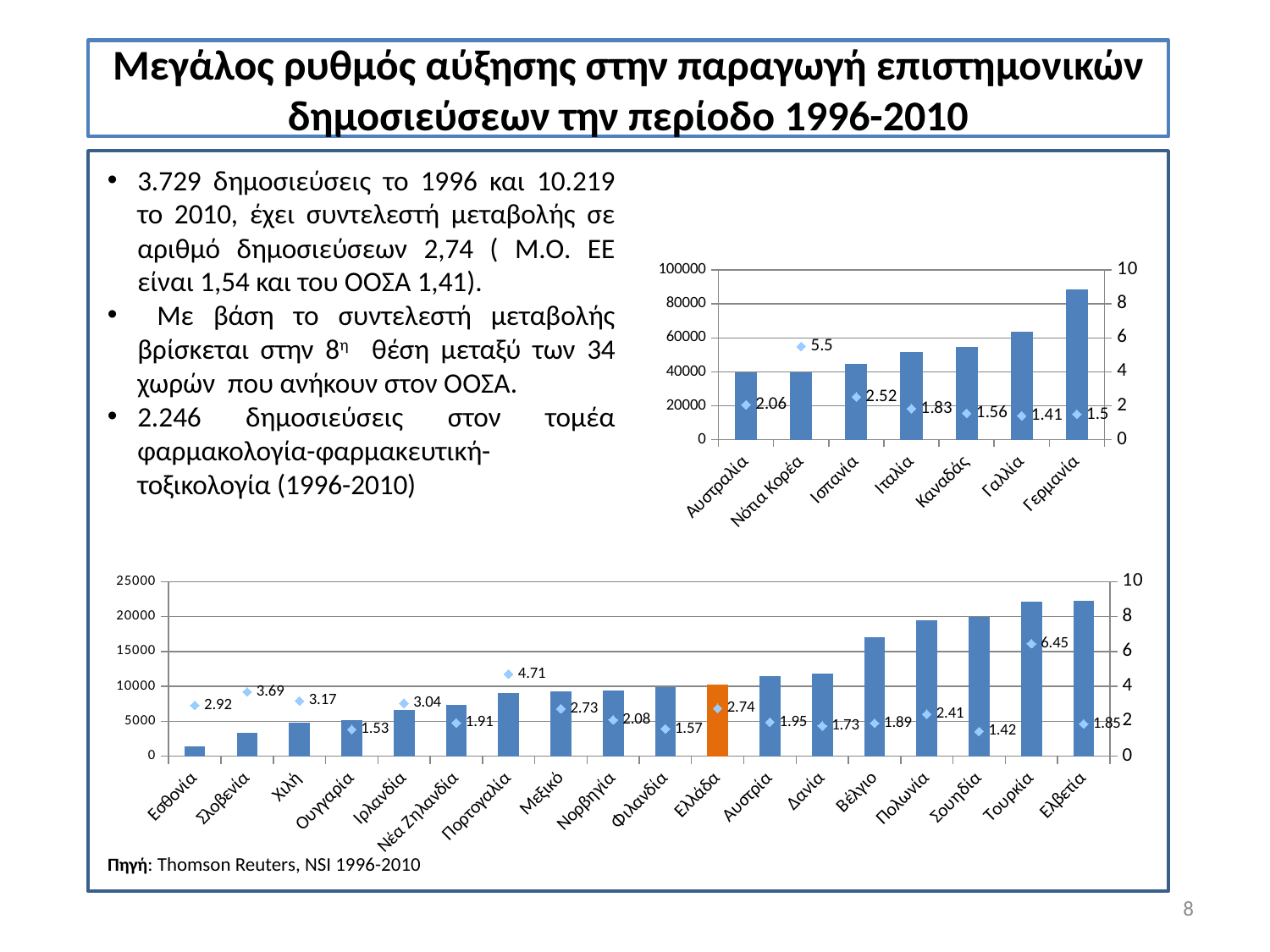
In the top-right chart, which has the larger labelled marker value, Ισπανία or Ιταλία? Ισπανία In the top-right chart, which country has the tallest bar? Γερμανία In the bottom chart, what is the labelled marker value for Ελλάδα? 2.74 In the bottom chart, which country has the highest labelled marker value? Τουρκία In the bottom chart, what is the difference between the labelled marker values of Τουρκία and Ελλάδα? 3.71 How many countries are shown on the x axis of the bottom chart? 18 In the bottom chart, which country's bar is coloured orange instead of blue? Ελλάδα In the top-right chart, what is the labelled marker value for Νότια Κορέα? 5.5 In the bottom chart, is the bar value for Ελλάδα greater or less than 5000? greater In the bottom chart, which country has the shortest bar? Εσθονία In the bottom chart, what is the labelled marker value for Τουρκία? 6.45 In the bottom chart, which country has the lowest labelled marker value? Σουηδία